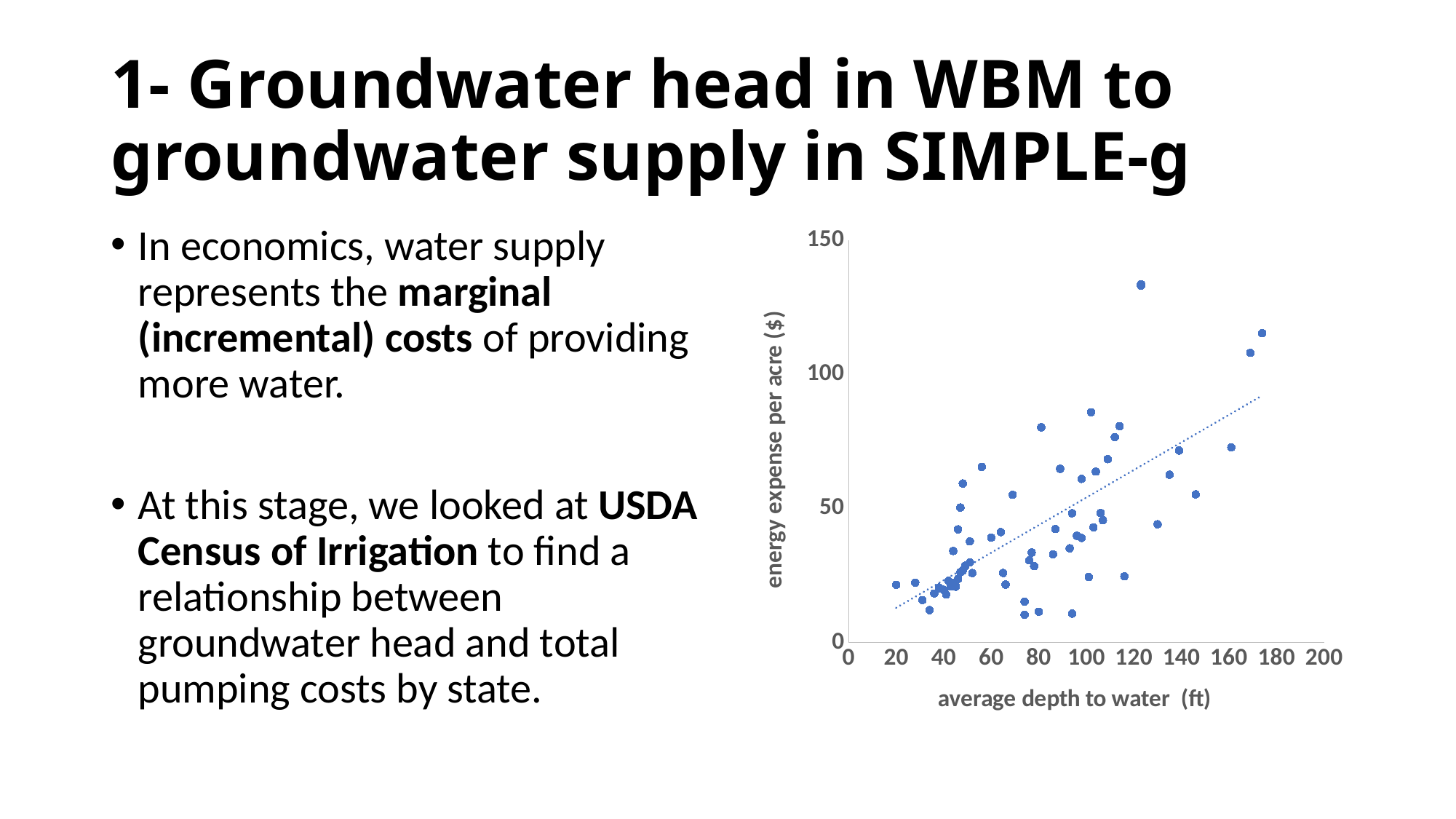
For the points with the largest average depth to water (around 170-180 ft), is the energy expense per acre greater or less than 100? greater Is the highest energy expense per acre plotted greater or less than 150? less Is the lowest energy expense per acre plotted greater or less than 50? less As average depth to water increases, does energy expense per acre generally rise or fall? rise What is the label of the x axis of the chart? average depth to water (ft) Does the dotted trend line slope upward or downward along the x axis? upward What is the label of the y axis of the chart? energy expense per acre ($) What kind of chart is shown on the slide? scatter plot